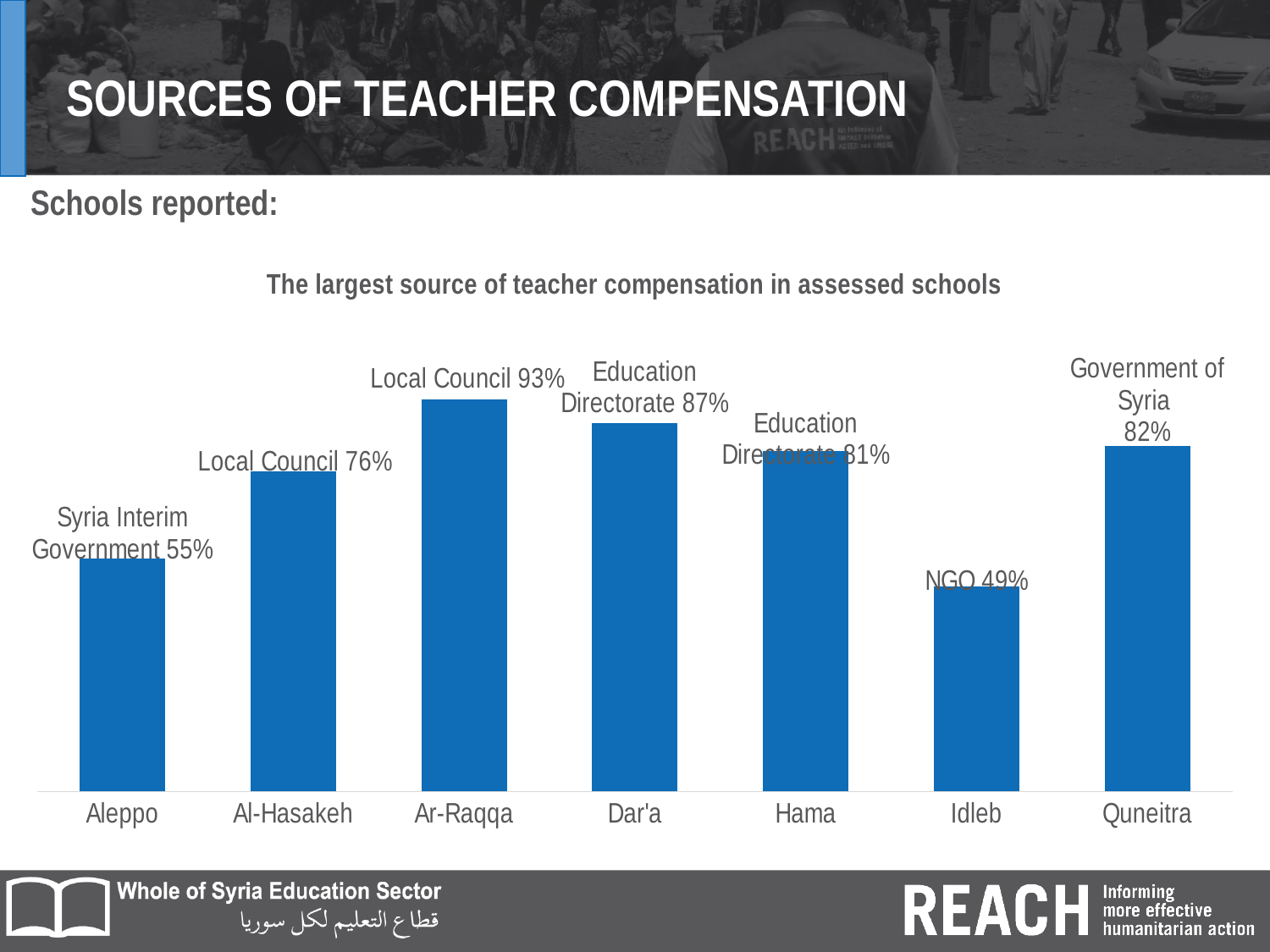
Which governorate has the lowest value? Idleb What is the difference between the values for Ar-Raqqa and Aleppo? 38% What is the title of the chart? The largest source of teacher compensation in assessed schools How many governorates are shown on the chart? 7 Which is larger, the value for Dar'a or the value for Hama? Dar'a What is the value for Quneitra? 82% What is the largest source of teacher compensation in Aleppo? Syria Interim Government What is the value for Idleb? 49% What kind of chart is this? Bar chart Which governorate has the highest value? Ar-Raqqa What is the difference between the values for Quneitra and Idleb? 33% What is the value for Ar-Raqqa? 93%